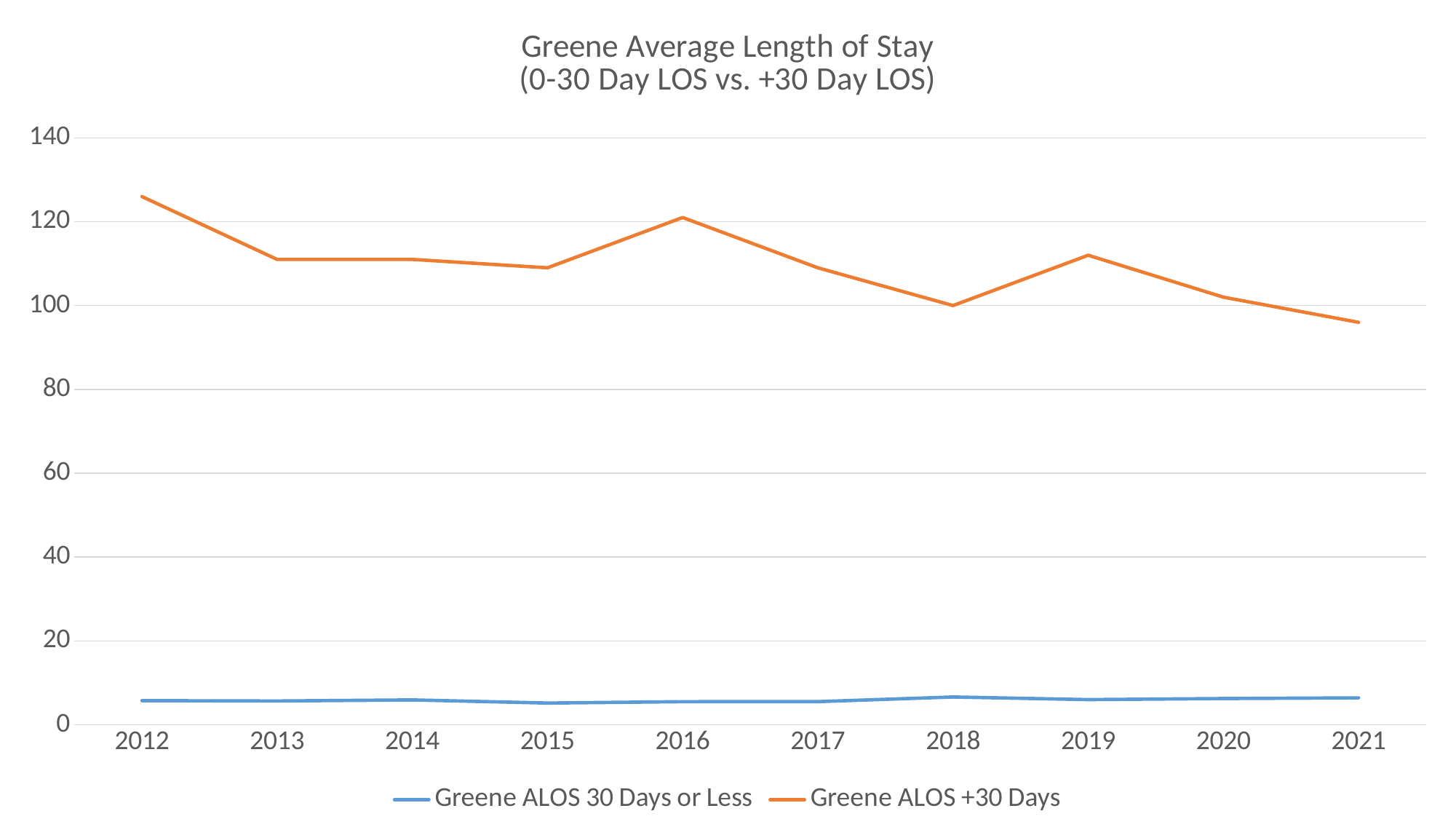
Which year has the highest value for Greene ALOS +30 Days? 2012 Is the value for Greene ALOS +30 Days in 2012 greater or less than 120? greater Overall, does the Greene ALOS +30 Days line rise or fall from 2012 to 2021? Fall Is the value for Greene ALOS 30 Days or Less in 2015 greater or less than 20? less Which year has the lowest value for Greene ALOS +30 Days? 2021 How many series does the legend list? 2 How many years are shown on the x axis? 10 In 2015, which series has the higher value: Greene ALOS 30 Days or Less or Greene ALOS +30 Days? Greene ALOS +30 Days What colour is the line for Greene ALOS +30 Days? Orange What kind of chart is shown on the slide? Line chart Which is larger for Greene ALOS +30 Days: the value in 2016 or the value in 2018? 2016 Is the value for Greene ALOS +30 Days in 2021 greater or less than 100? less